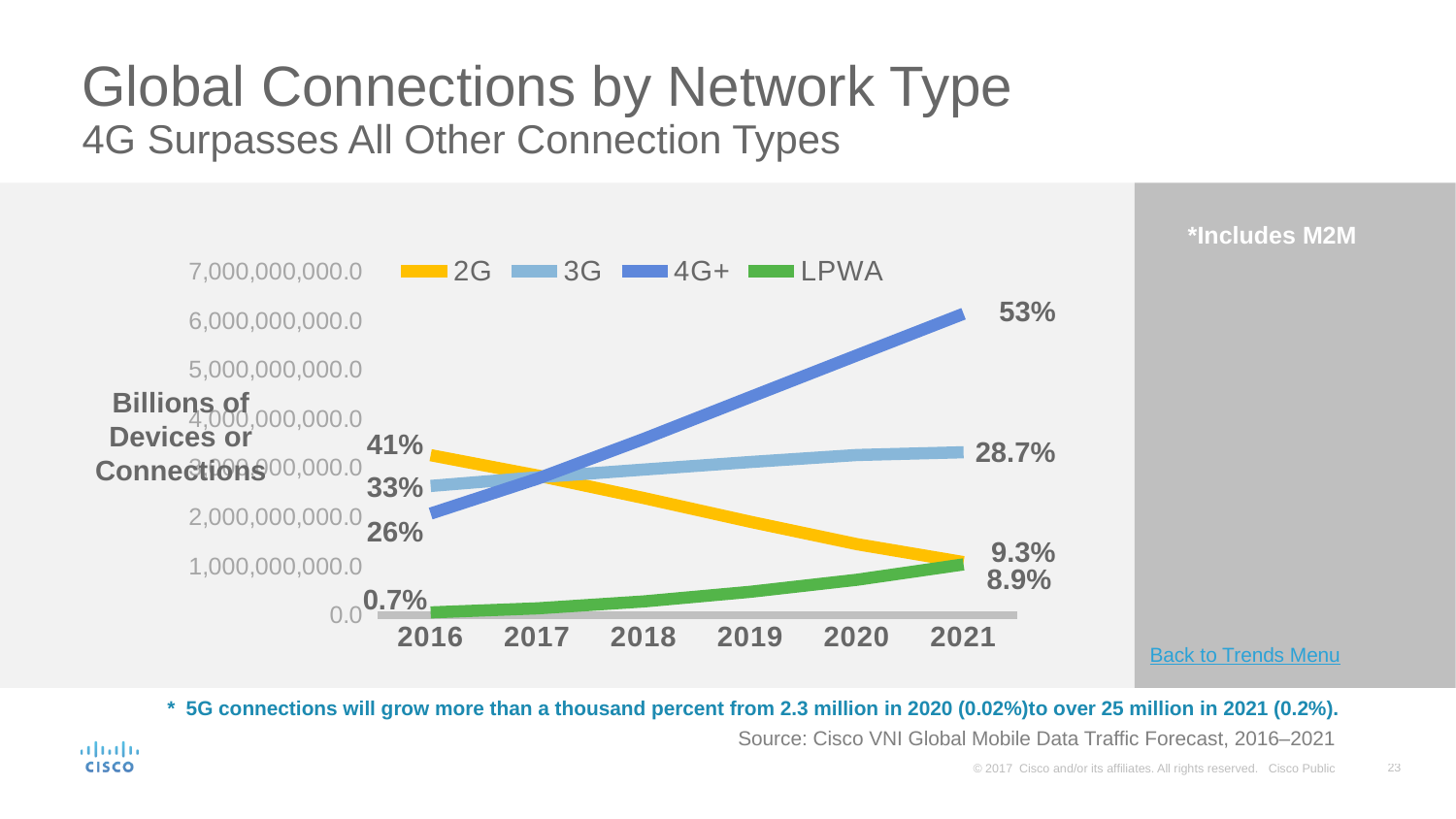
What percentage label is shown for 3G in 2021? 28.7% What percentage label is shown for 2G in 2016? 41% How many years are shown on the x axis of the chart? 6 Which network type has the lowest value in 2016? LPWA Is the value for 4G+ in 2021 greater or less than 5,000,000,000.0? greater What kind of chart is shown on the slide? Line chart Does the 2G line rise or fall from 2016 to 2021? Fall What percentage label is shown for 4G+ in 2021? 53% Which network type has the highest value in 2021? 4G+ How many series does the chart legend list? 4 What percentage label is shown for LPWA in 2016? 0.7% By how many percentage points does the 4G+ label change from 2016 to 2021? 27 percentage points